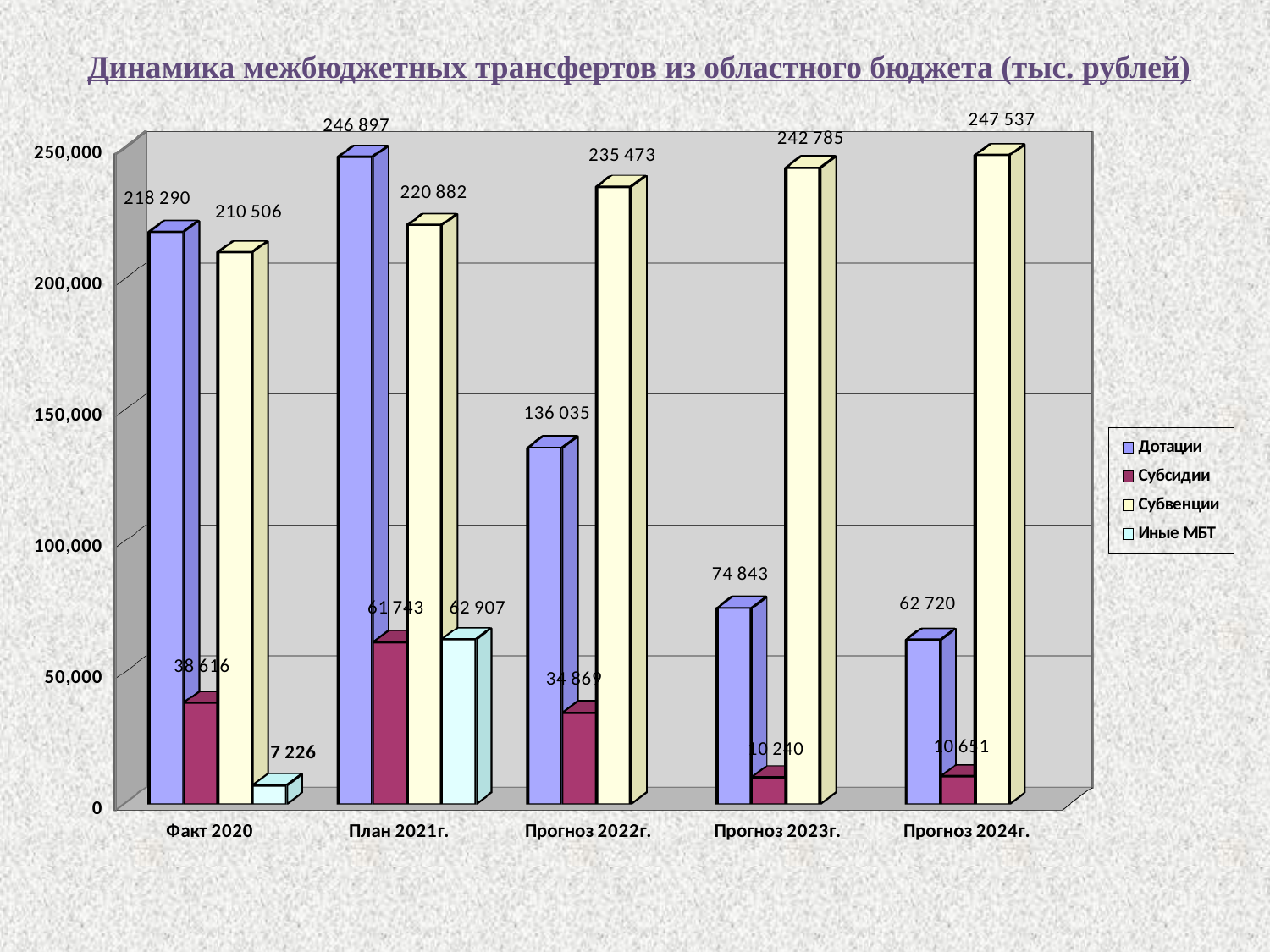
How many series does the legend list? 4 What is the difference between Субвенции for Прогноз 2024г. and Субвенции for Прогноз 2022г.? 12 064 What is the value of Иные МБТ for Факт 2020? 7 226 How many categories are shown on the x axis? 5 For Факт 2020, which is larger: Дотации or Субвенции? Дотации In which category is the Дотации value the highest? План 2021г. In which category is the Дотации value the lowest? Прогноз 2024г. What is the value of Субвенции for Прогноз 2024г.? 247 537 What is the value of Дотации for Факт 2020? 218 290 By how much does Дотации for План 2021г. exceed Дотации for Факт 2020? 28 607 Is the value of Субсидии for Факт 2020 greater or less than 50,000? less What type of chart is shown on the slide? bar chart